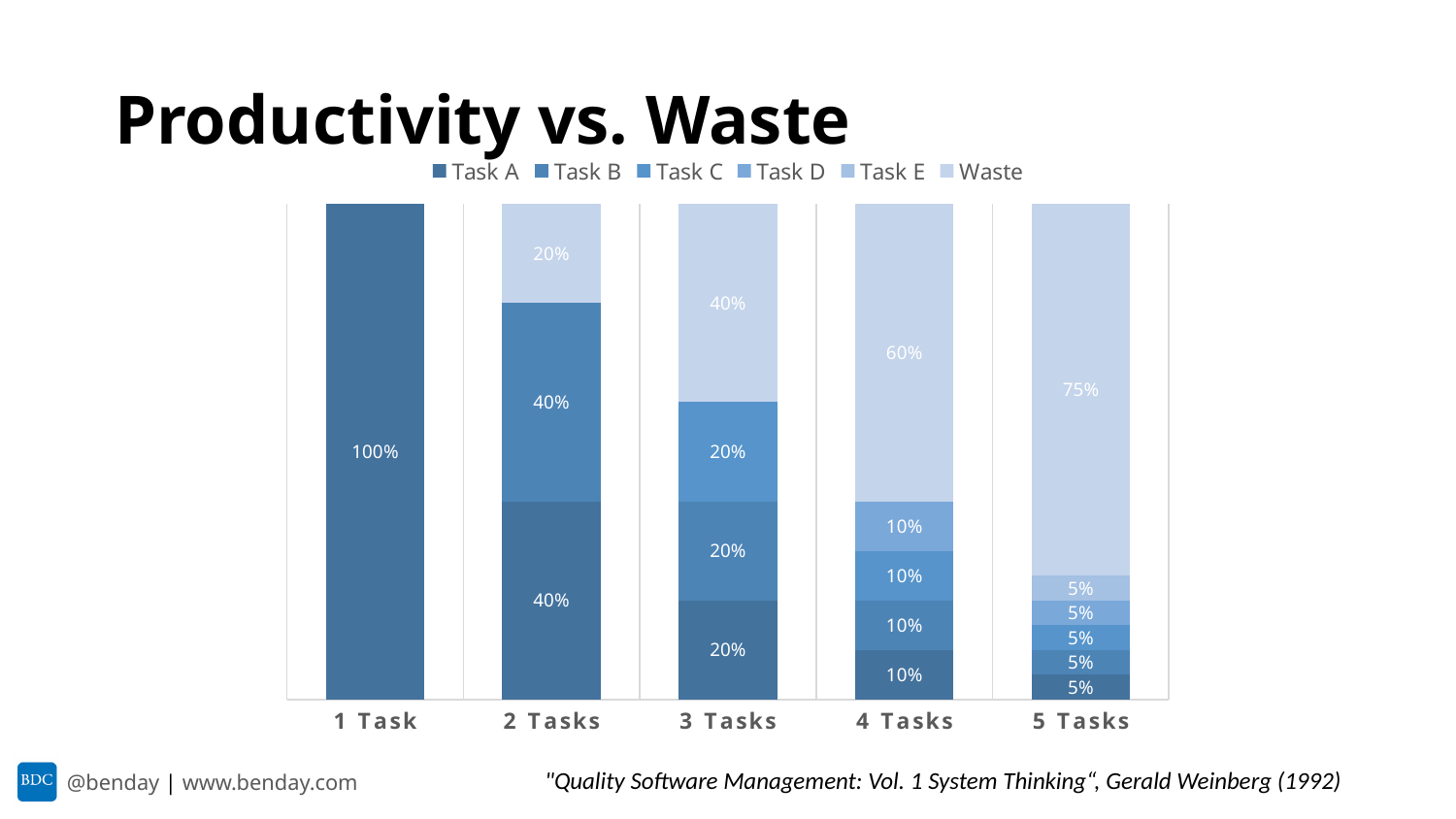
Does the Waste value rise or fall as the number of tasks increases from 2 Tasks to 5 Tasks? Rises What is the Waste value for 4 Tasks? 60% What is the title of the chart? Productivity vs. Waste What is the Task B value for 2 Tasks? 40% How many categories are shown on the x axis? 5 What kind of chart is shown on the slide? Stacked bar chart What is the Task A value for 1 Task? 100% Which category has the largest Waste segment? 5 Tasks What is the Waste value for 5 Tasks? 75% How many series does the legend list? 6 Which is larger, the Waste value for 3 Tasks or the Waste value for 2 Tasks? 3 Tasks What is the difference between the Waste value for 5 Tasks and the Waste value for 4 Tasks? 15%